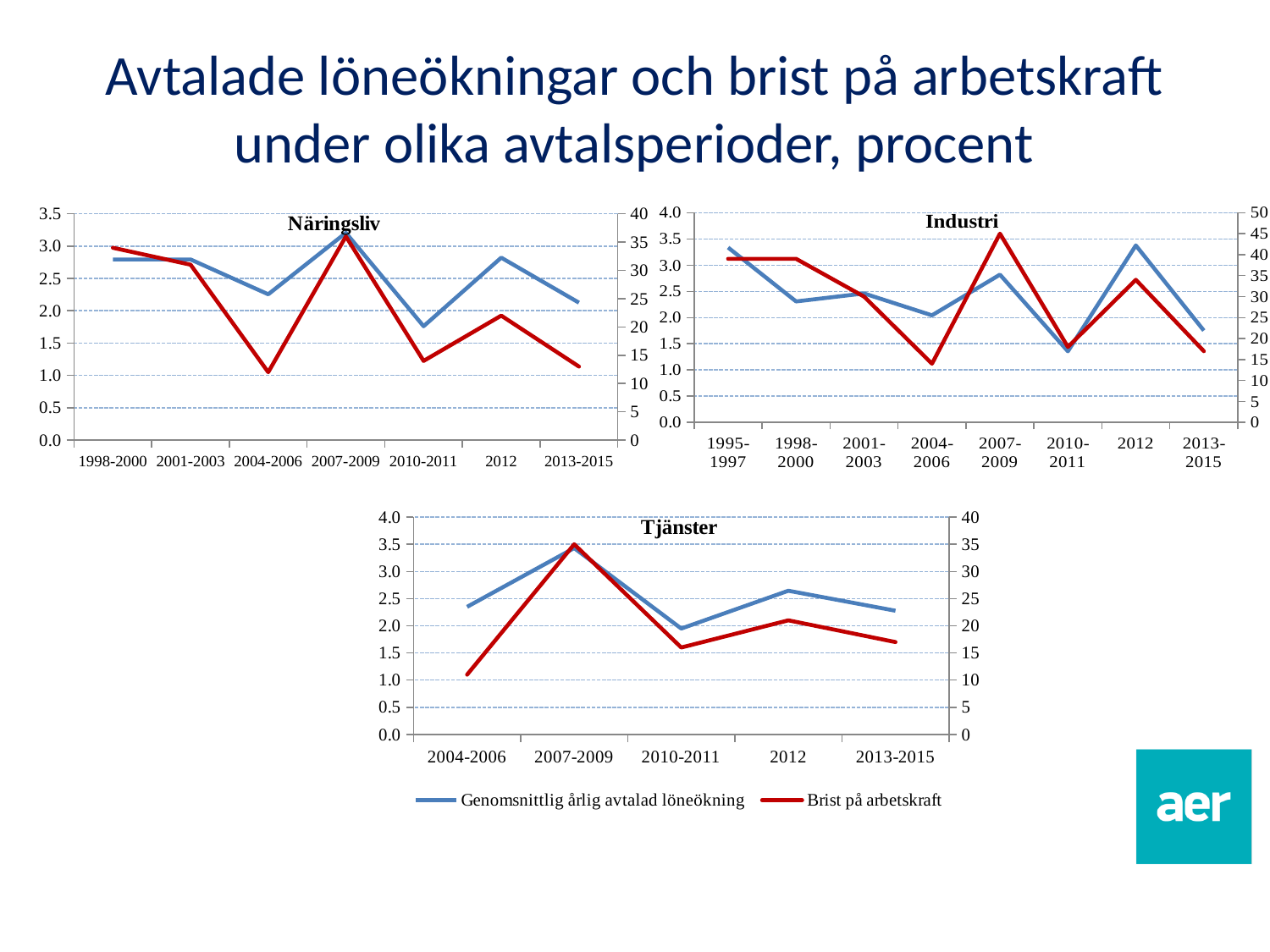
In the Industri chart, in which period is Brist på arbetskraft highest? 2007-2009 In the Industri chart, in which period is Genomsnittlig årlig avtalad löneökning lowest? 2010-2011 In the Näringsliv chart, in which period is Genomsnittlig årlig avtalad löneökning highest? 2007-2009 How many periods are shown on the x axis of the Industri chart? 8 How many series does the legend at the bottom of the slide list? 2 In the Tjänster chart, does Genomsnittlig årlig avtalad löneökning rise or fall from 2012 to 2013-2015? fall In the Tjänster chart, in which period is Brist på arbetskraft lowest? 2004-2006 Which series is drawn in red in the charts? Brist på arbetskraft What kind of chart is the Näringsliv chart? line chart In the Näringsliv chart, is the value of Genomsnittlig årlig avtalad löneökning for 2004-2006 greater or less than 2.0? greater How many periods are shown on the x axis of the Tjänster chart? 5 In the Industri chart, is the value of Brist på arbetskraft for 2004-2006 greater or less than 20? less